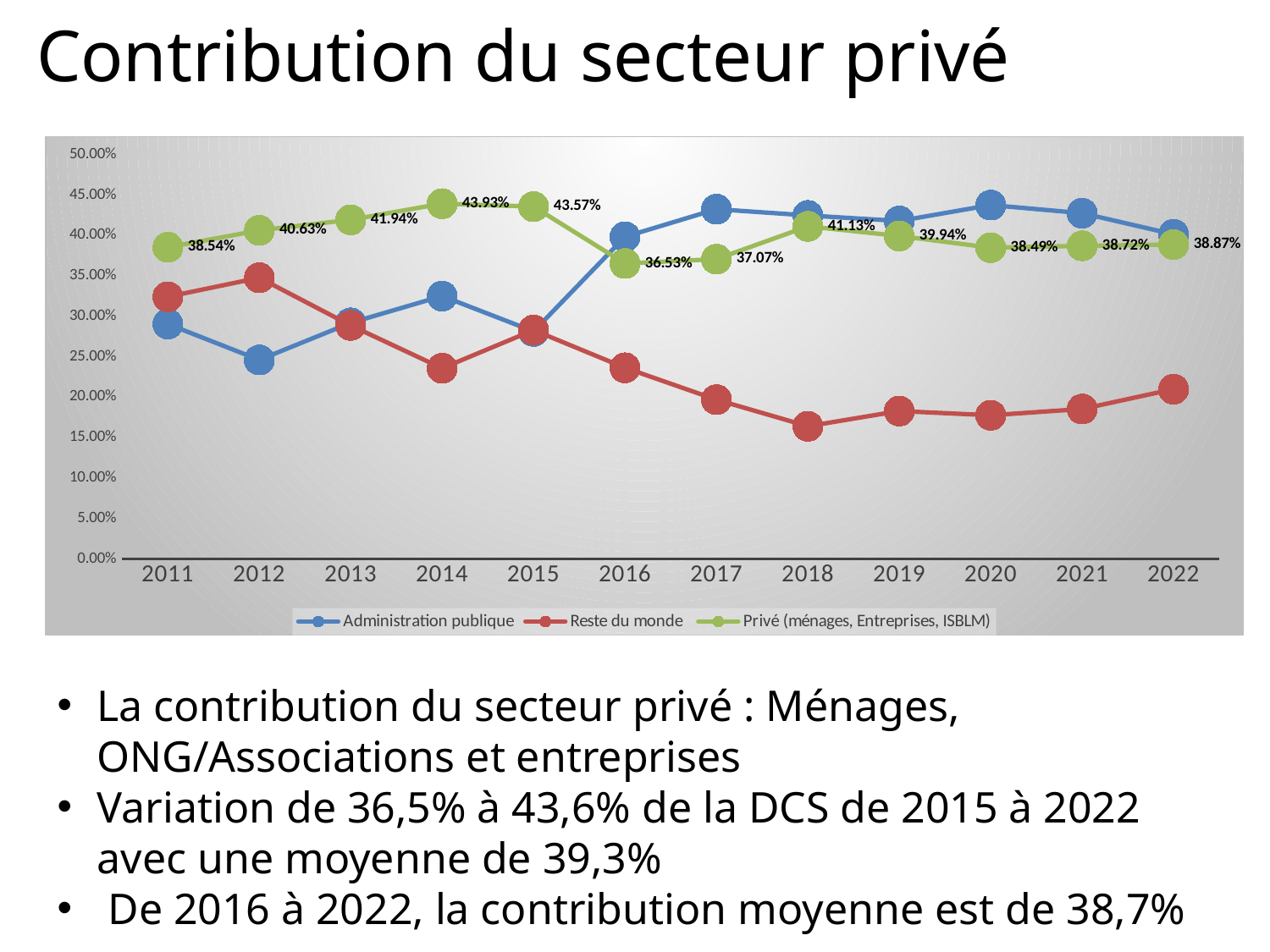
What is the value for Privé (ménages, Entreprises, ISBLM) in 2016? 36.53% What kind of chart is shown on the slide? Line chart How many series does the legend list? 3 What is the value for Privé (ménages, Entreprises, ISBLM) in 2014? 43.93% What is the difference between the Privé (ménages, Entreprises, ISBLM) values for 2014 and 2016? 7.40% Which is larger for Privé (ménages, Entreprises, ISBLM): the value in 2013 or the value in 2019? 2013 In which year is the Privé (ménages, Entreprises, ISBLM) series at its highest? 2014 What is the value for Privé (ménages, Entreprises, ISBLM) in 2022? 38.87% In which year is the Privé (ménages, Entreprises, ISBLM) series at its lowest? 2016 Is the value for Reste du monde in 2018 greater or less than 20.00%? less Is the value for Administration publique in 2020 greater or less than 40.00%? greater How many years are shown on the x axis? 12